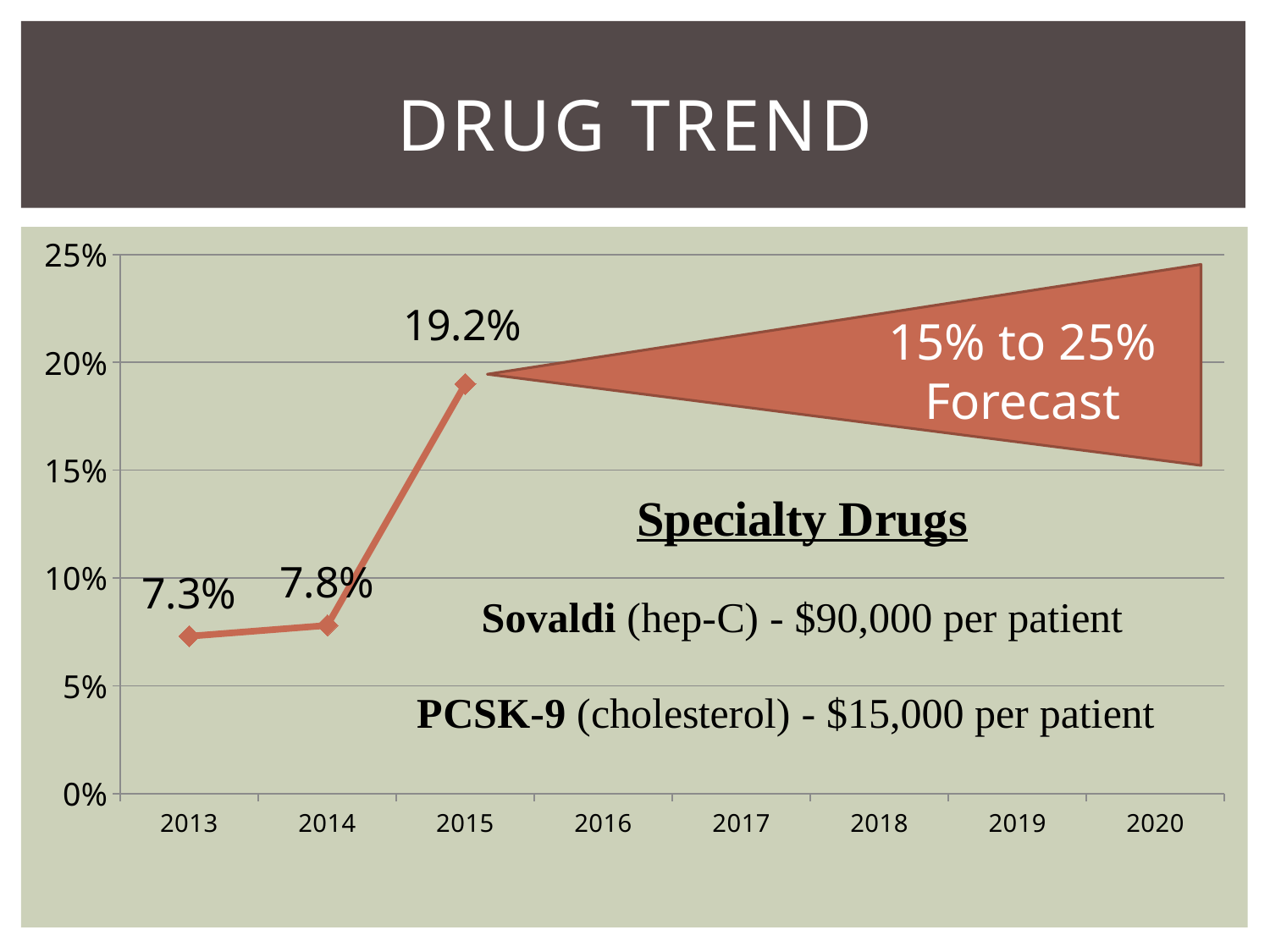
What is the drug trend value for 2015? 19.2% What is the difference between the 2014 and 2013 values? 0.5% Which year has the lowest plotted drug trend value? 2013 What kind of chart is shown on the slide? line chart Which year has the highest plotted drug trend value? 2015 What is the difference between the 2015 and 2014 values? 11.4% Is the value for 2015 greater or less than 15%? greater How many data points are plotted on the line? 3 What is the drug trend value for 2014? 7.8% What is the drug trend value for 2013? 7.3% Do the plotted values rise or fall from 2013 to 2015? rise Which is larger, the value for 2015 or the value for 2014? 2015